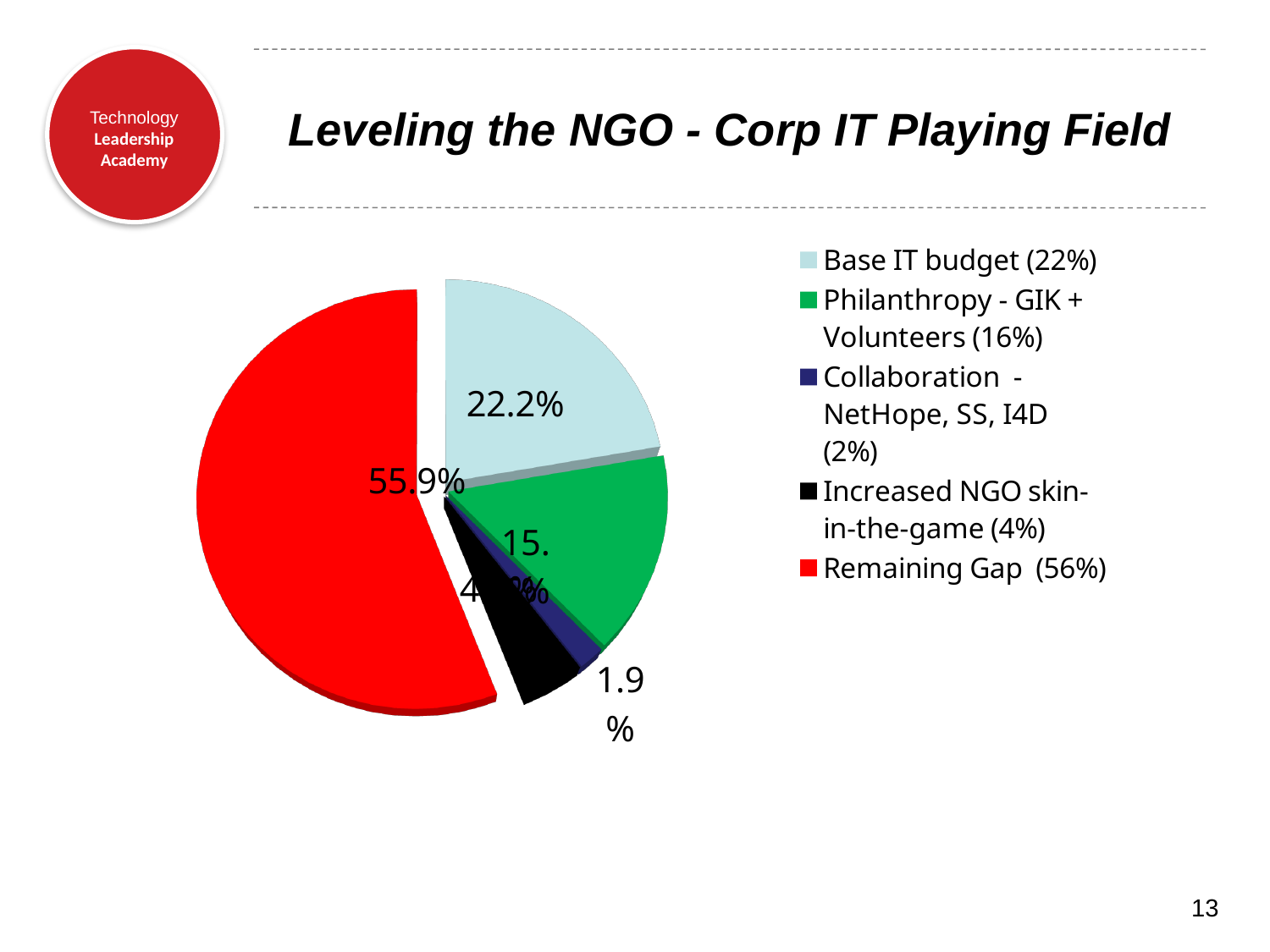
What colour is the Remaining Gap slice? red What kind of chart is shown on the slide? pie chart How many slices does the pie chart have? 5 Which category has the smallest slice of the pie? Collaboration - NetHope, SS, I4D What is the difference between the Remaining Gap slice (55.9%) and the Base IT budget slice (22.2%)? 33.7% What percentage is shown on the Remaining Gap slice? 55.9% What percentage is shown on the Collaboration - NetHope, SS, I4D slice? 1.9% What percentage is shown on the Base IT budget slice? 22.2% Which is larger, the Base IT budget slice or the Remaining Gap slice? Remaining Gap Which category has the largest slice of the pie? Remaining Gap How many entries does the legend list? 5 What percentage does the legend give for Philanthropy - GIK + Volunteers? 16%